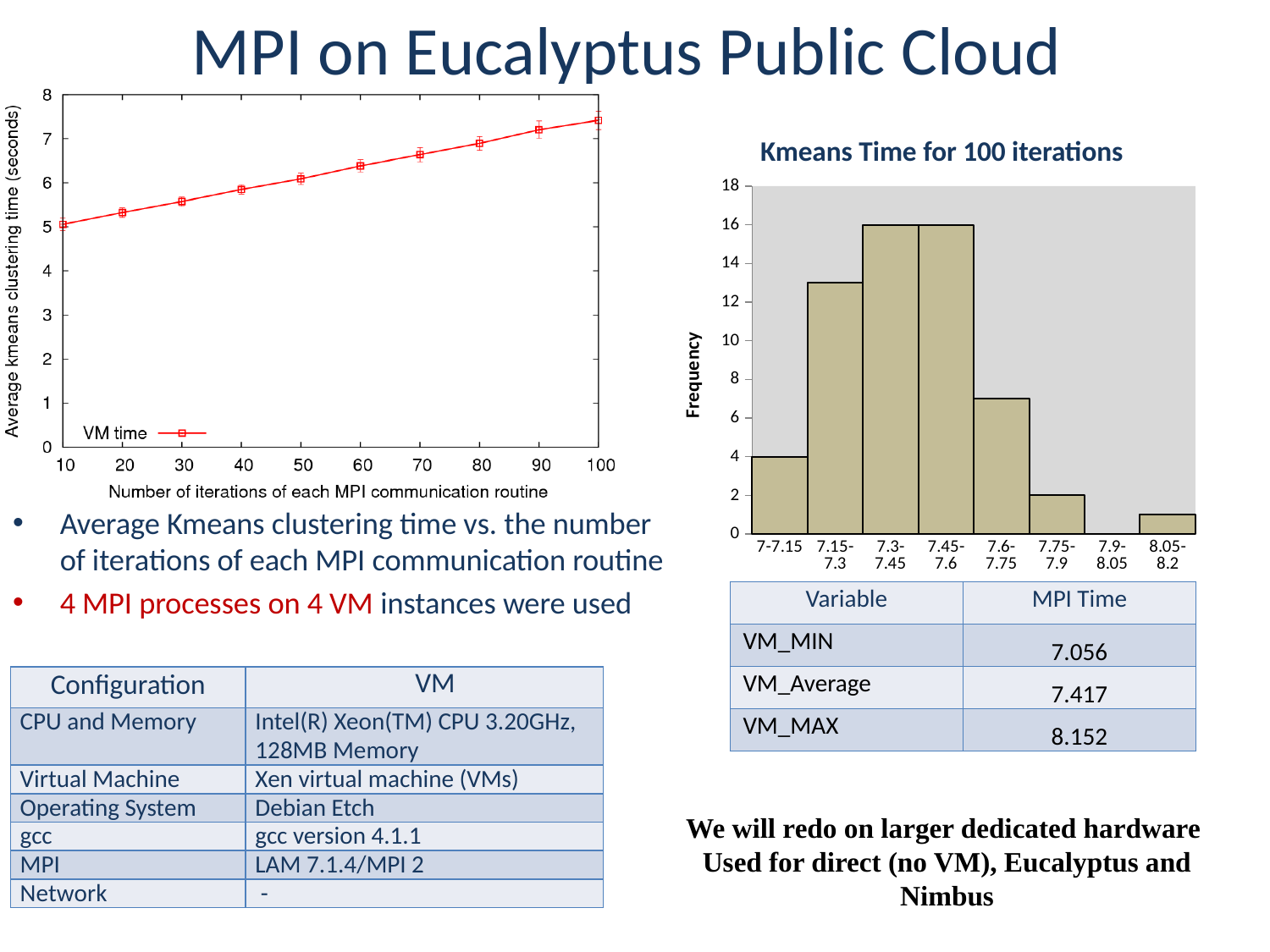
In the left line chart, is the value at 10 iterations greater or less than 6? less In the left line chart, does the average Kmeans clustering time rise or fall as the number of iterations increases? rise How many bins are shown in the 'Kmeans Time for 100 iterations' chart? 8 How many data points are plotted in the left line chart? 10 In the 'Kmeans Time for 100 iterations' chart, what is the frequency for the 7.45-7.6 bin? 16 In the left line chart, is the value at 100 iterations greater or less than 7? greater In the 'Kmeans Time for 100 iterations' chart, which bin has the lowest frequency? 7.9-8.05 What type of chart is the 'Kmeans Time for 100 iterations' chart? bar chart In the 'Kmeans Time for 100 iterations' chart, what is the frequency for the 7.75-7.9 bin? 2 What type of chart is the chart on the left of the slide? line chart What series name is shown in the legend of the left line chart? VM time In the 'Kmeans Time for 100 iterations' chart, what is the frequency for the 7-7.15 bin? 4